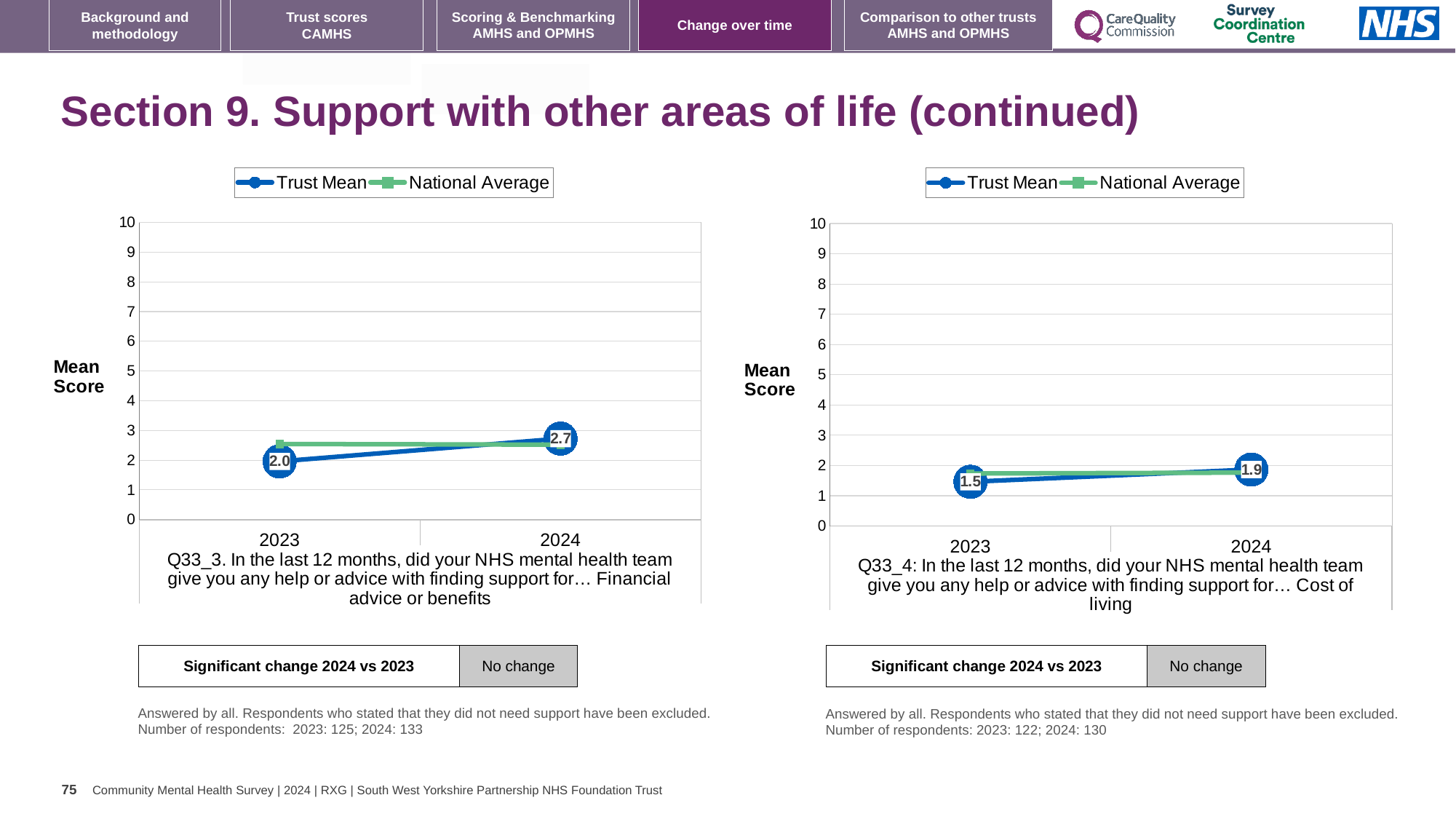
What kind of chart is the right chart (Q33_4, Cost of living)? line chart How many series does the legend of the left chart list? 2 On the left chart (Q33_3), by how much did the Trust Mean change from 2023 to 2024? 0.7 On the right chart (Q33_4, Cost of living), what is the Trust Mean for 2024? 1.9 On the left chart (Q33_3), is the National Average for 2023 greater or less than 2? greater On the left chart (Q33_3), does the Trust Mean rise or fall from 2023 to 2024? rise On the right chart (Q33_4), what is the difference between the Trust Mean in 2024 and in 2023? 0.4 On the left chart (Q33_3, Financial advice or benefits), what is the Trust Mean for 2024? 2.7 On the left chart (Q33_3, Financial advice or benefits), what is the Trust Mean for 2023? 2.0 How many years are shown on the x axis of the right chart (Q33_4)? 2 On the right chart (Q33_4, Cost of living), what is the Trust Mean for 2023? 1.5 On the right chart (Q33_4), which year has the higher Trust Mean, 2023 or 2024? 2024